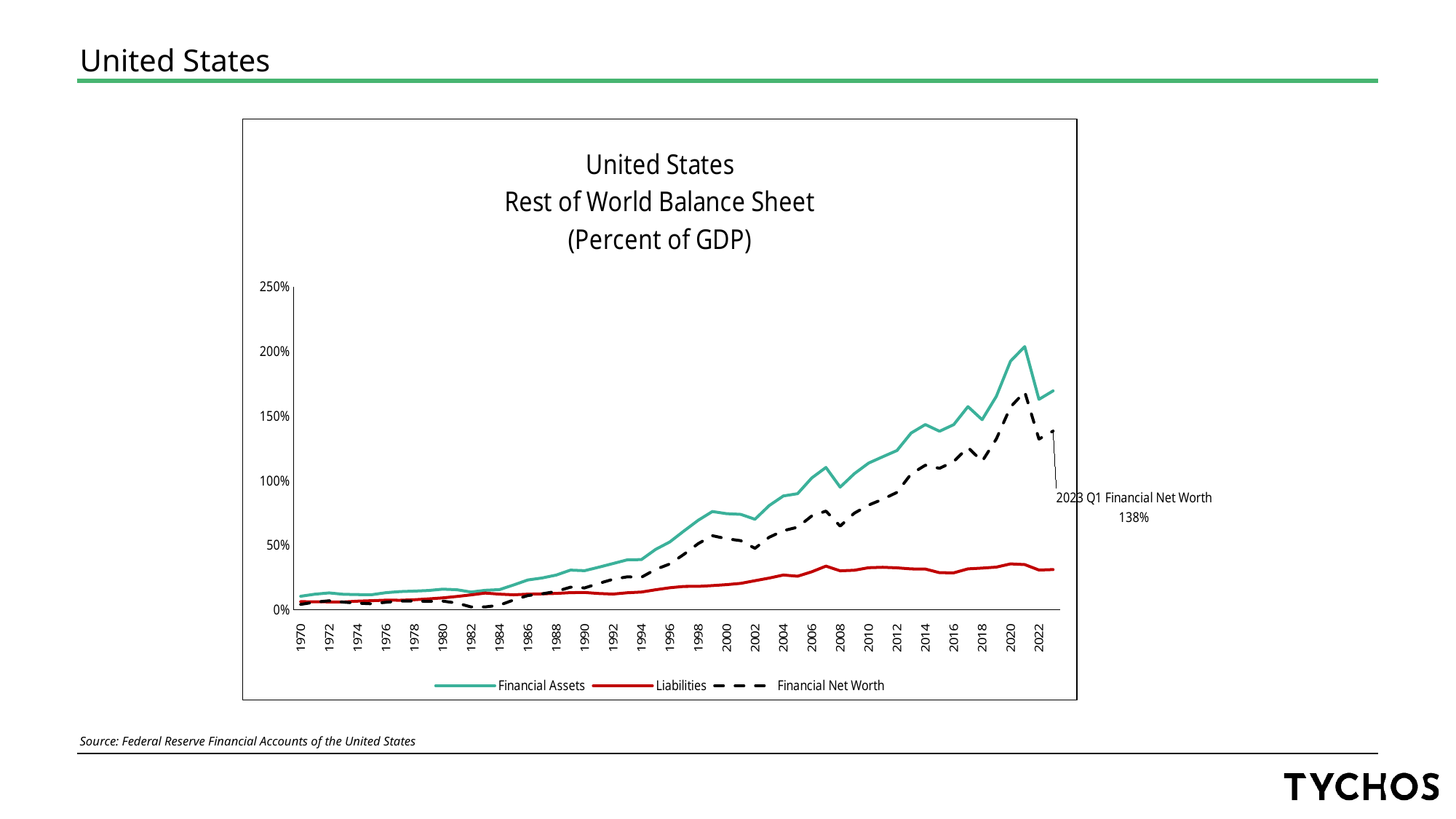
Which series is drawn as a dashed line? Financial Net Worth Is the value for Financial Assets in 2020 greater or less than 150%? greater Is the value for Financial Assets in 1970 greater or less than 50%? less Which series has the highest value in 2022? Financial Assets Which series has the lowest value in 2022? Liabilities How many series does the legend list? 3 In 2010, which is larger: Financial Assets or Liabilities? Financial Assets Do the Financial Assets values generally rise or fall from 1970 to 2020? rise What is the 2023 Q1 Financial Net Worth value labelled on the chart? 138% Is the value for Financial Net Worth in 2008 greater or less than 100%? less What kind of chart is shown on the slide? line chart